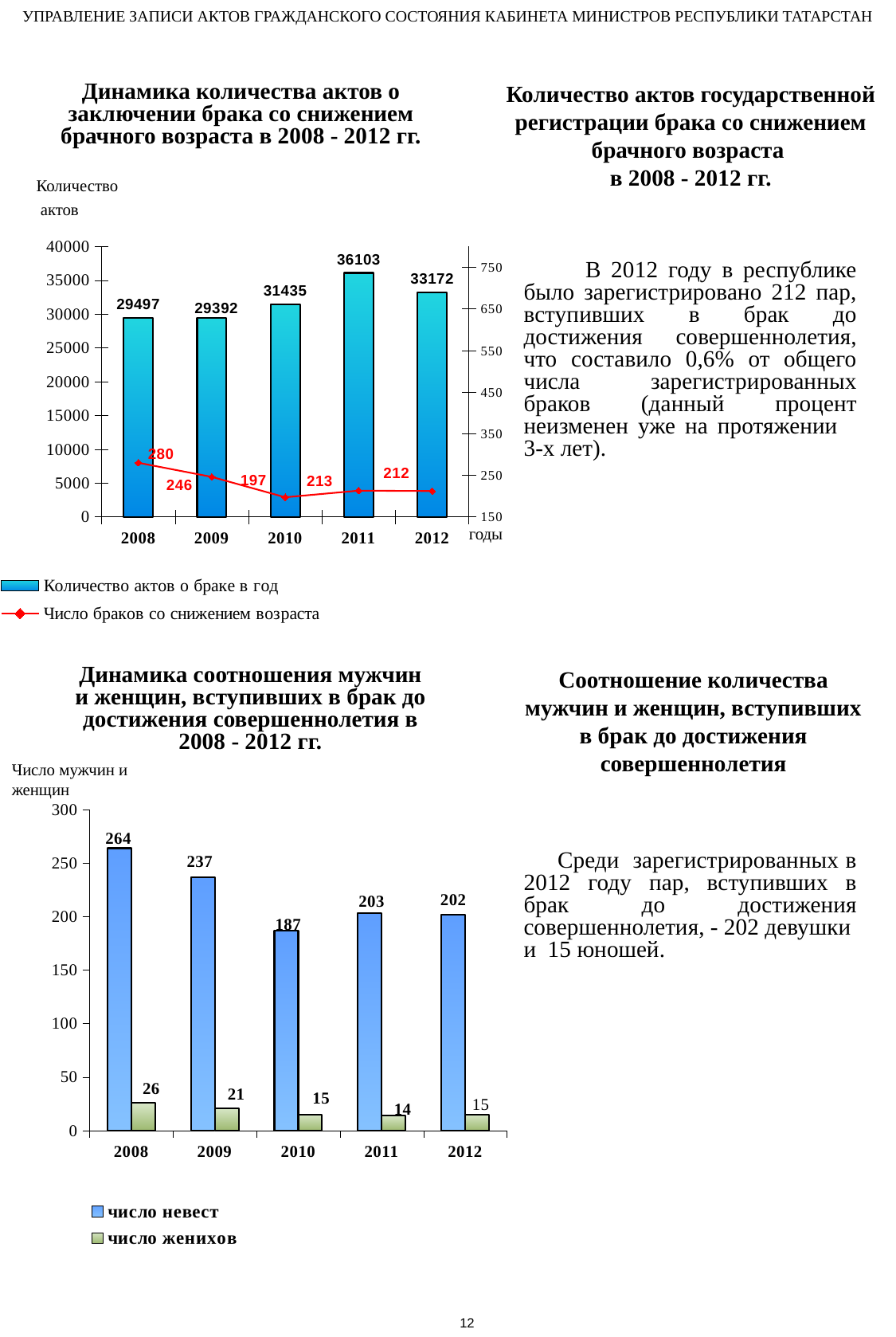
На нижней диаграмме «Динамика соотношения мужчин и женщин, вступивших в брак до достижения совершеннолетия» сколько невест было в 2009 году? 237 На нижней диаграмме в каком году число невест было наибольшим? 2008 На нижней диаграмме сколько женихов было в 2011 году? 14 На верхней диаграмме какое число браков со снижением возраста указано для 2010 года? 197 На верхней диаграмме «Динамика количества актов о заключении брака со снижением брачного возраста в 2008 - 2012 гг.» сколько актов о браке было в 2011 году? 36103 На нижней диаграмме что больше: число невест в 2010 году или в 2011 году? 2011 Какого типа нижняя диаграмма? Столбчатая (bar chart) На нижней диаграмме на сколько число невест в 2008 году больше числа женихов в 2008 году? 238 На верхней диаграмме сколько рядов данных перечислено в легенде? 2 На верхней диаграмме на сколько количество актов о браке в 2011 году больше, чем в 2012 году? 2931 На верхней диаграмме в каком году количество актов о браке в год было наибольшим? 2011 На верхней диаграмме в каком году число браков со снижением возраста было наименьшим? 2010